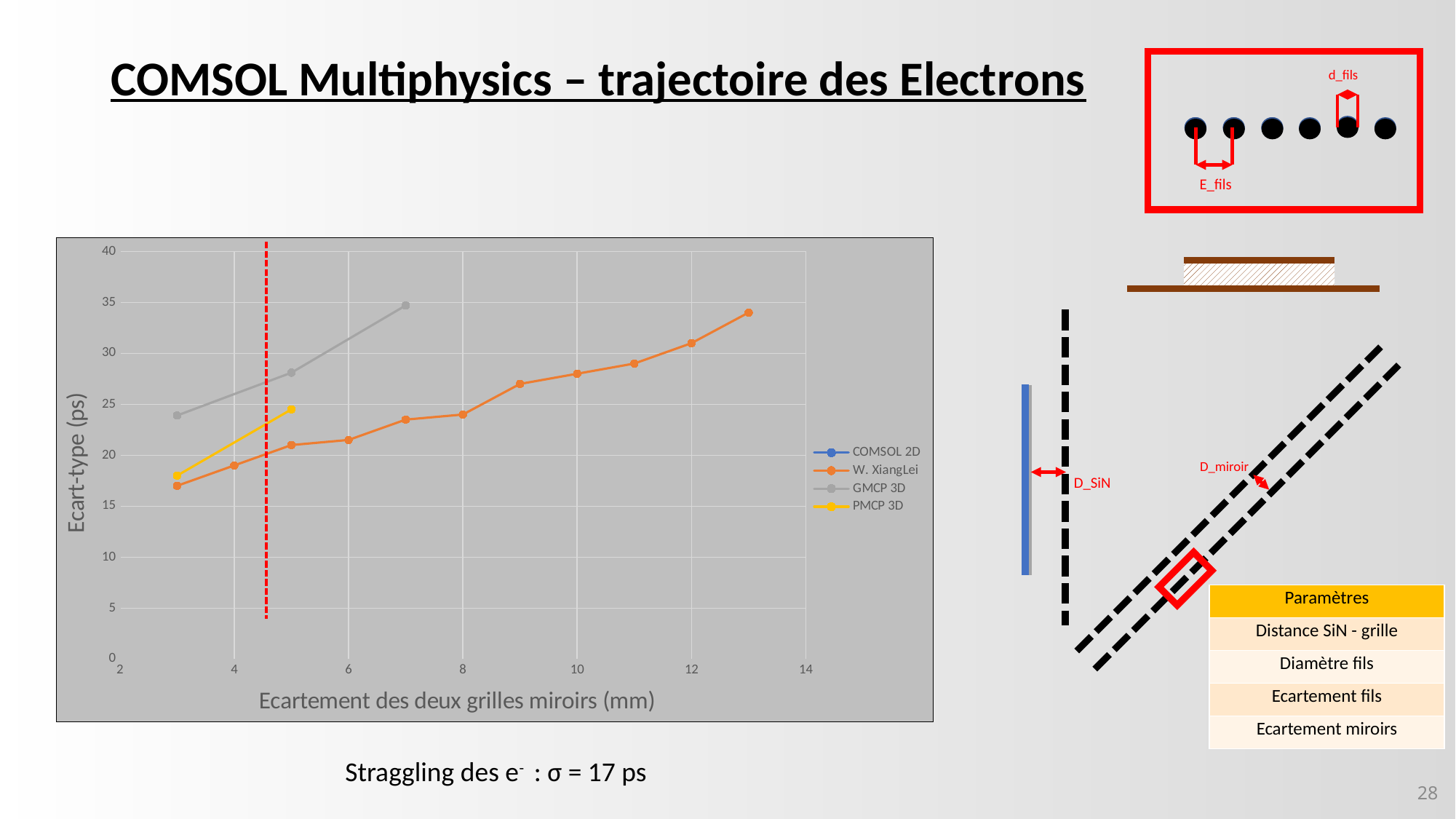
At 3 mm, which series has the higher value: GMCP 3D or W. XiangLei? GMCP 3D Is the value of the W. XiangLei series at 3 mm greater or less than 20? less What is the title of the x axis of the chart? Ecartement des deux grilles miroirs (mm) Is the value of the PMCP 3D series at 5 mm greater or less than 20? greater What kind of chart is shown on the slide? line chart Does the W. XiangLei series rise or fall as the x-axis value increases? rise What is the title of the y axis of the chart? Ecart-type (ps) How many series does the chart legend list? 4 At 5 mm, which series has the higher value: PMCP 3D or W. XiangLei? PMCP 3D How many data points are plotted for the GMCP 3D series? 3 Is the value of the W. XiangLei series at 13 mm greater or less than 30? greater